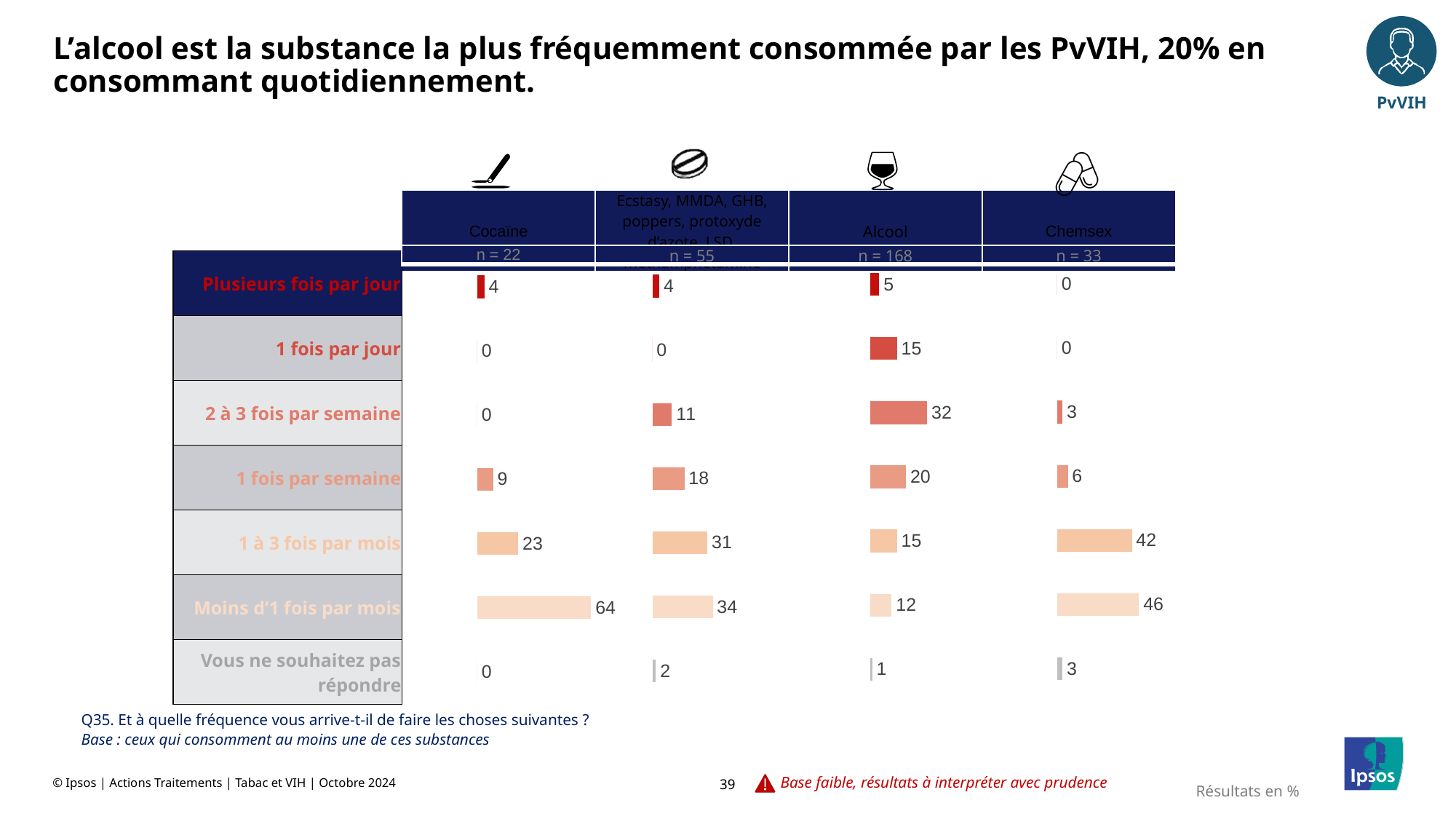
In the Alcool chart, which category has the highest value? 2 à 3 fois par semaine In the Alcool chart, what is the value for "2 à 3 fois par semaine"? 32 How many frequency categories are shown in each chart? 7 In the Chemsex chart, which category has the highest value? Moins d'1 fois par mois In the Chemsex chart, what is the value for "1 à 3 fois par mois"? 42 In the Chemsex chart, what is the difference between "Moins d'1 fois par mois" and "1 à 3 fois par mois"? 4 In the Alcool chart, what is the difference between "2 à 3 fois par semaine" and "1 fois par jour"? 17 In the Cocaïne chart, what is the value for "Moins d'1 fois par mois"? 64 In the Ecstasy, MMDA, GHB, poppers chart, what is the value for "1 fois par semaine"? 18 Which is larger: the "1 à 3 fois par mois" value in the Cocaïne chart or in the Ecstasy, MMDA, GHB, poppers chart? Ecstasy, MMDA, GHB, poppers What type of chart is used to show the frequencies for each substance? Bar chart What is the sample size (n) shown for the Alcool chart? n = 168